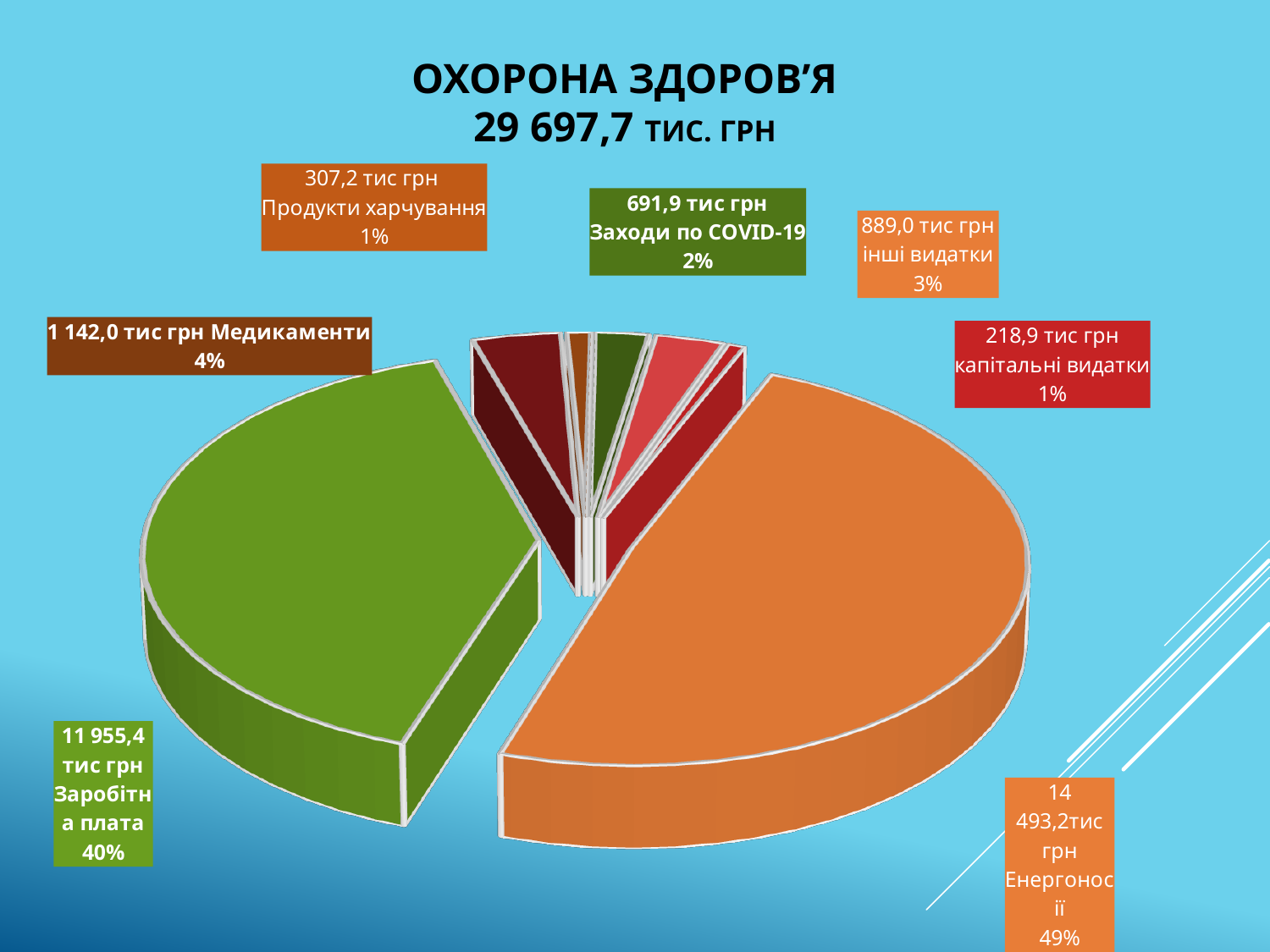
What kind of chart is shown on the slide? pie chart What share of the pie does Енергоносії take? 49% Which category has the largest slice? Енергоносії What is the value for Медикаменти? 1 142,0 тис грн What is the value for Заходи по COVID-19? 691,9 тис грн Which is larger, the value for Медикаменти or the value for інші видатки? Медикаменти Which category has the smallest value? капітальні видатки What is the difference between the values for Енергоносії and Заробітна плата? 2 537,8 тис грн What is the value for Енергоносії? 14 493,2 тис грн What is the value for Заробітна плата? 11 955,4 тис грн What share of the pie does інші видатки take? 3% How many categories does the pie chart show? 7